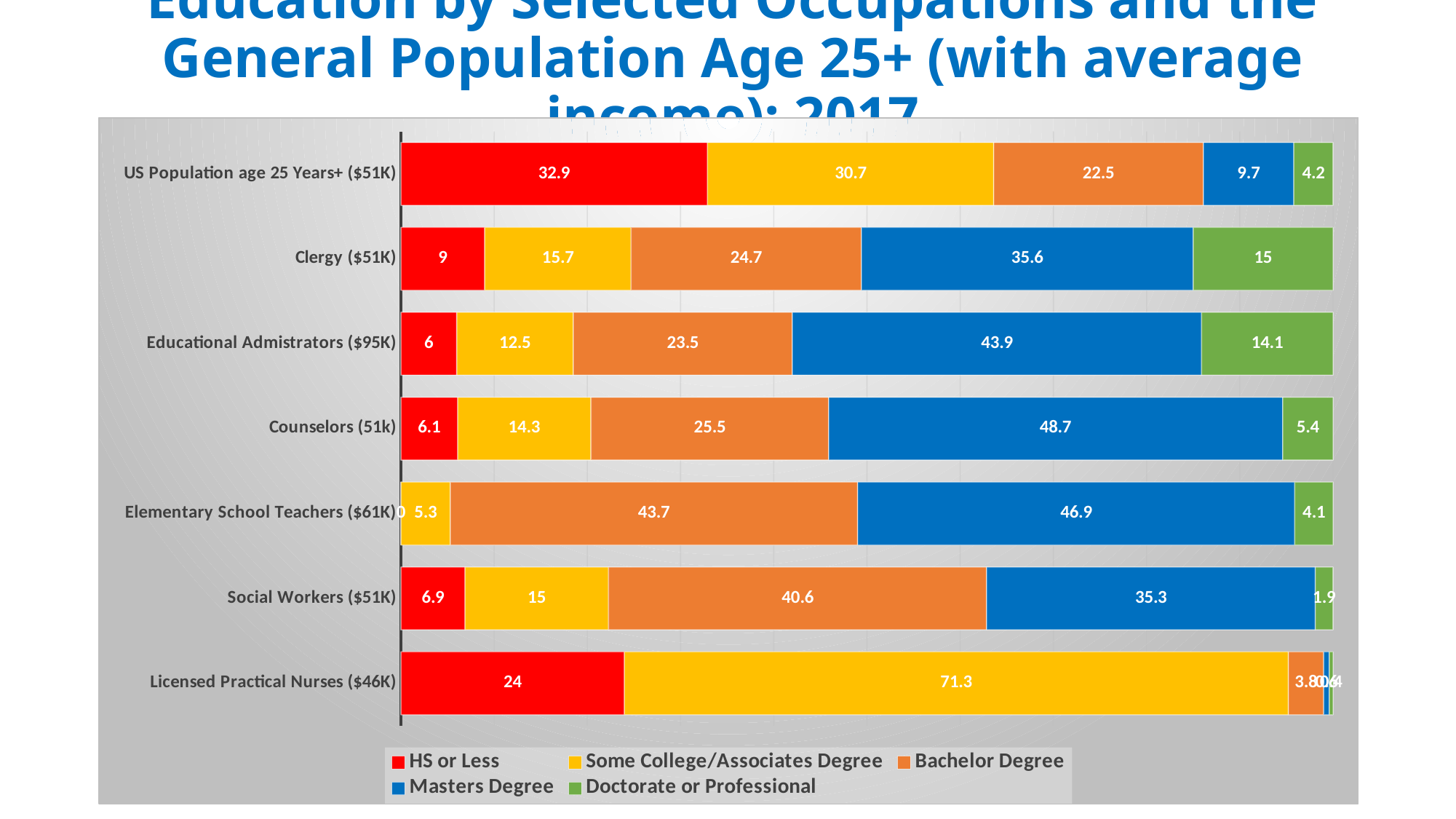
How many series does the legend list? 5 What is the Some College/Associates Degree value for Licensed Practical Nurses ($46K)? 71.3 What type of chart is shown on the slide? stacked bar chart What colour represents the Bachelor Degree series in the legend? orange What is the total of the stacked bar for Clergy ($51K)? 100 Which category has the lowest Doctorate or Professional value among those with a readable label? Social Workers ($51K) Which is larger: the Doctorate or Professional value for Clergy ($51K) or for Educational Admistrators ($95K)? Clergy ($51K) Which category has the highest Masters Degree value? Counselors (51k) What is the difference between the Bachelor Degree values for Elementary School Teachers ($61K) and Social Workers ($51K)? 3.1 What is the Masters Degree value for Counselors (51k)? 48.7 How many occupation/population categories are shown on the chart? 7 What is the HS or Less value for US Population age 25 Years+ ($51K)? 32.9